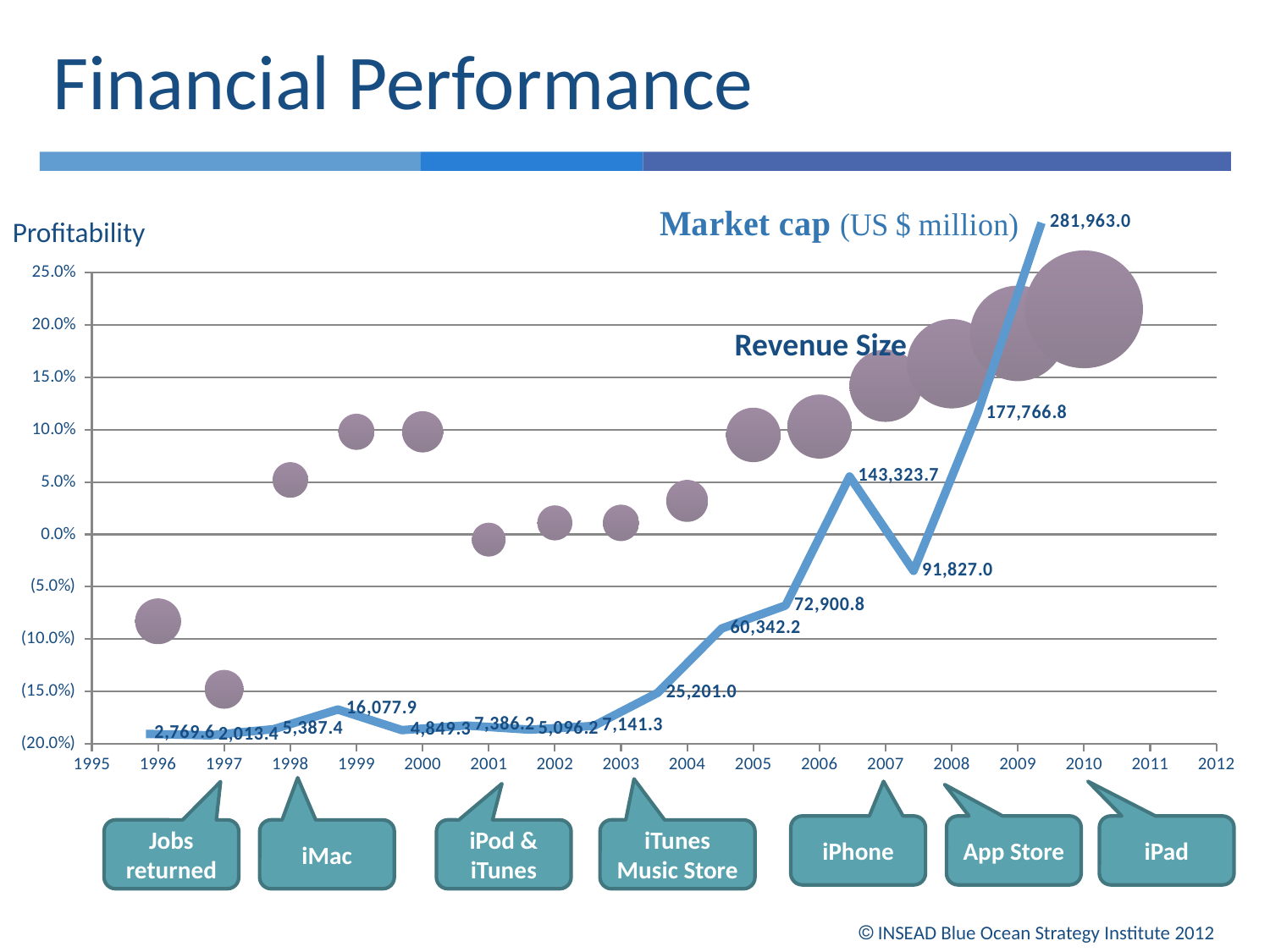
How many market cap data points are labelled on the line? 15 What is the market cap value shown for 2004? 25,201.0 In which year is the market cap highest? 2010 What is the market cap value shown for 1999? 16,077.9 What is the market cap value shown for 2010? 281,963.0 Is the profitability shown by the 1996 bubble greater or less than 0.0%? less What is the difference between the market cap in 2010 and in 2009? 104,196.2 Is the profitability shown by the 2010 bubble greater or less than 15.0%? greater In which year is the market cap lowest? 1997 What is the difference between the market cap in 2007 and in 2008? 51,496.7 Which year has the larger market cap, 2006 or 2008? 2008 What is the market cap value shown for 2007? 143,323.7